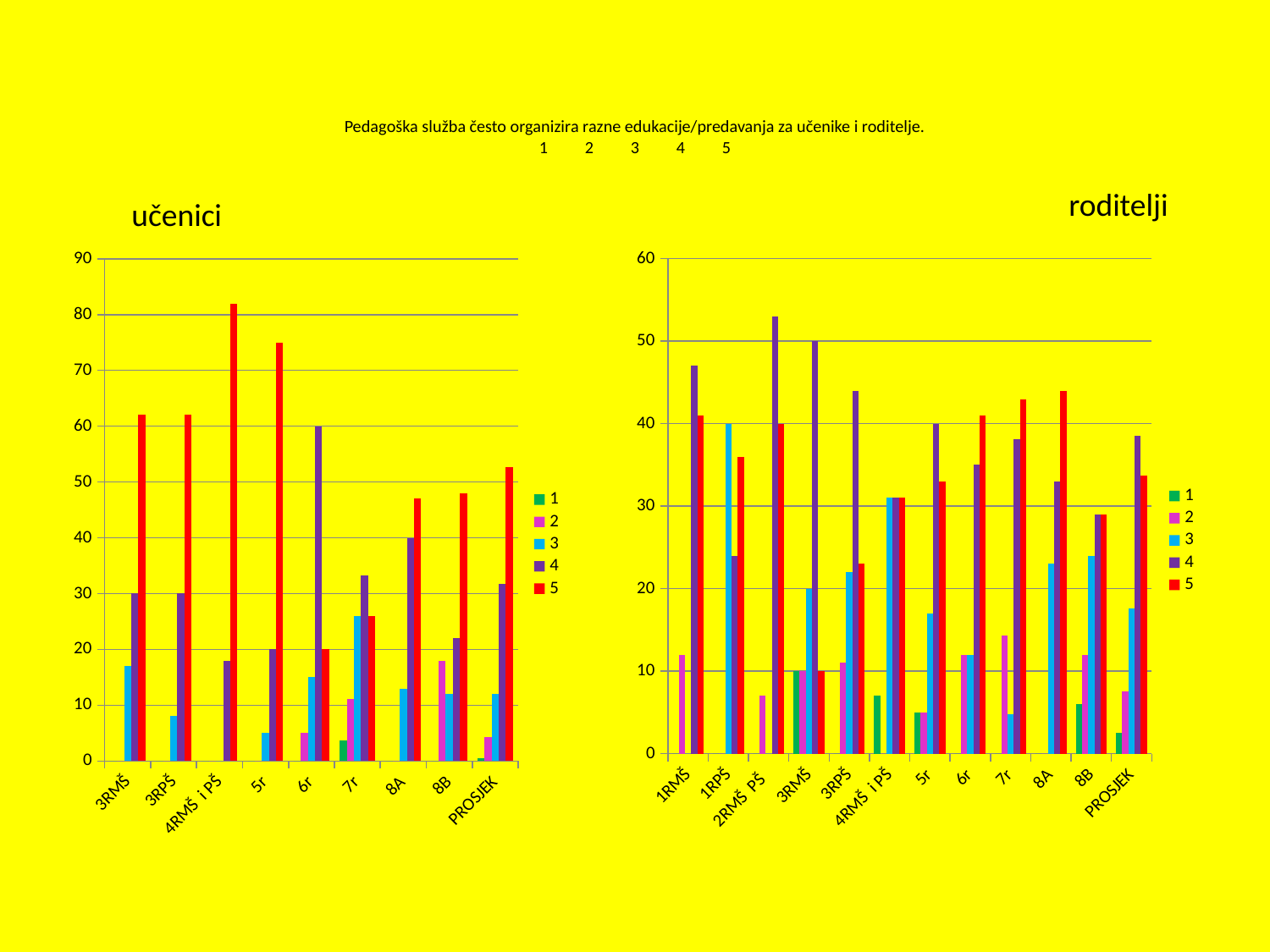
How many series does the legend of the 'roditelji' chart list? 5 In the 'roditelji' chart, which category has the lowest value for series 5? 3RMŠ How many categories are shown on the x axis of the 'roditelji' chart? 12 In the 'roditelji' chart, for 1RMŠ, which is larger: series 4 or series 5? series 4 In the 'učenici' chart, what is the value of series 4 for 6r? 60 In the 'roditelji' chart, is the value of series 4 for 2RMŠ PŠ greater or less than 50? greater In the 'učenici' chart, which category has the highest value for series 5? 4RMŠ i PŠ What kind of chart is the 'učenici' chart on the left? bar chart In the 'učenici' chart, is the value of series 3 for 7r greater or less than 20? greater What is the title of the chart on the right side of the slide? roditelji In the 'učenici' chart, is the value of series 5 for 5r greater or less than 70? greater How many categories are shown on the x axis of the 'učenici' chart? 9